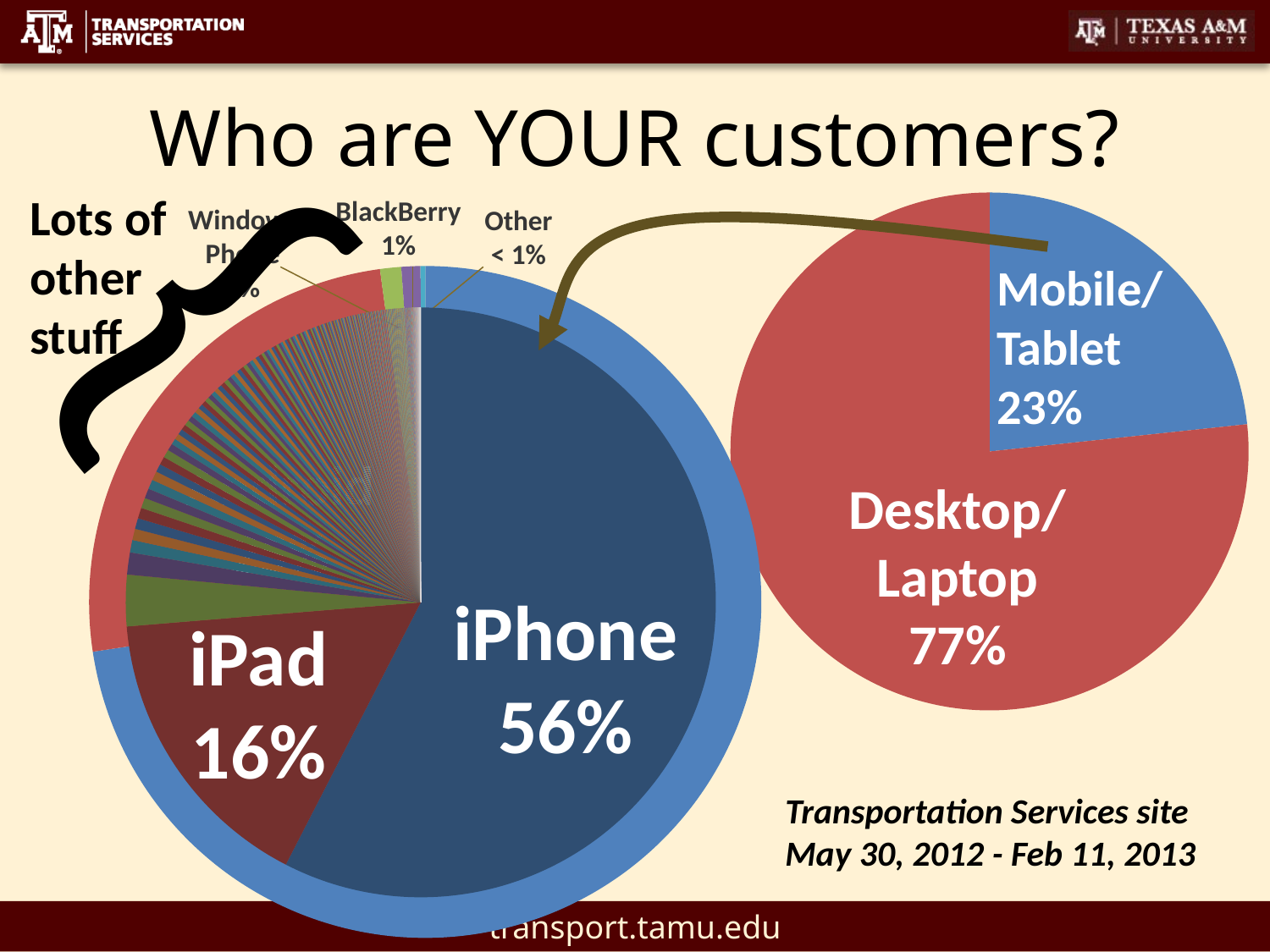
In the pie chart on the right, what share is Mobile/Tablet? 23% In the large pie chart on the left, what share is iPad? 16% In the large pie chart on the left, what share is iPhone? 56% In the pie chart on the right, what share is Desktop/Laptop? 77% In the large pie chart on the left, which is larger, iPad or BlackBerry? iPad In the large pie chart on the left, what share is BlackBerry? 1% What date range is given for the data on the slide? May 30, 2012 - Feb 11, 2013 In the pie chart on the right, how many percentage points larger is Desktop/Laptop than Mobile/Tablet? 54 percentage points In the large pie chart on the left, how many percentage points larger is iPhone than iPad? 40 percentage points What kind of charts are shown on the slide? Pie charts In the pie chart on the right, which category has the larger share? Desktop/Laptop In the large pie chart on the left, which category has the largest share? iPhone